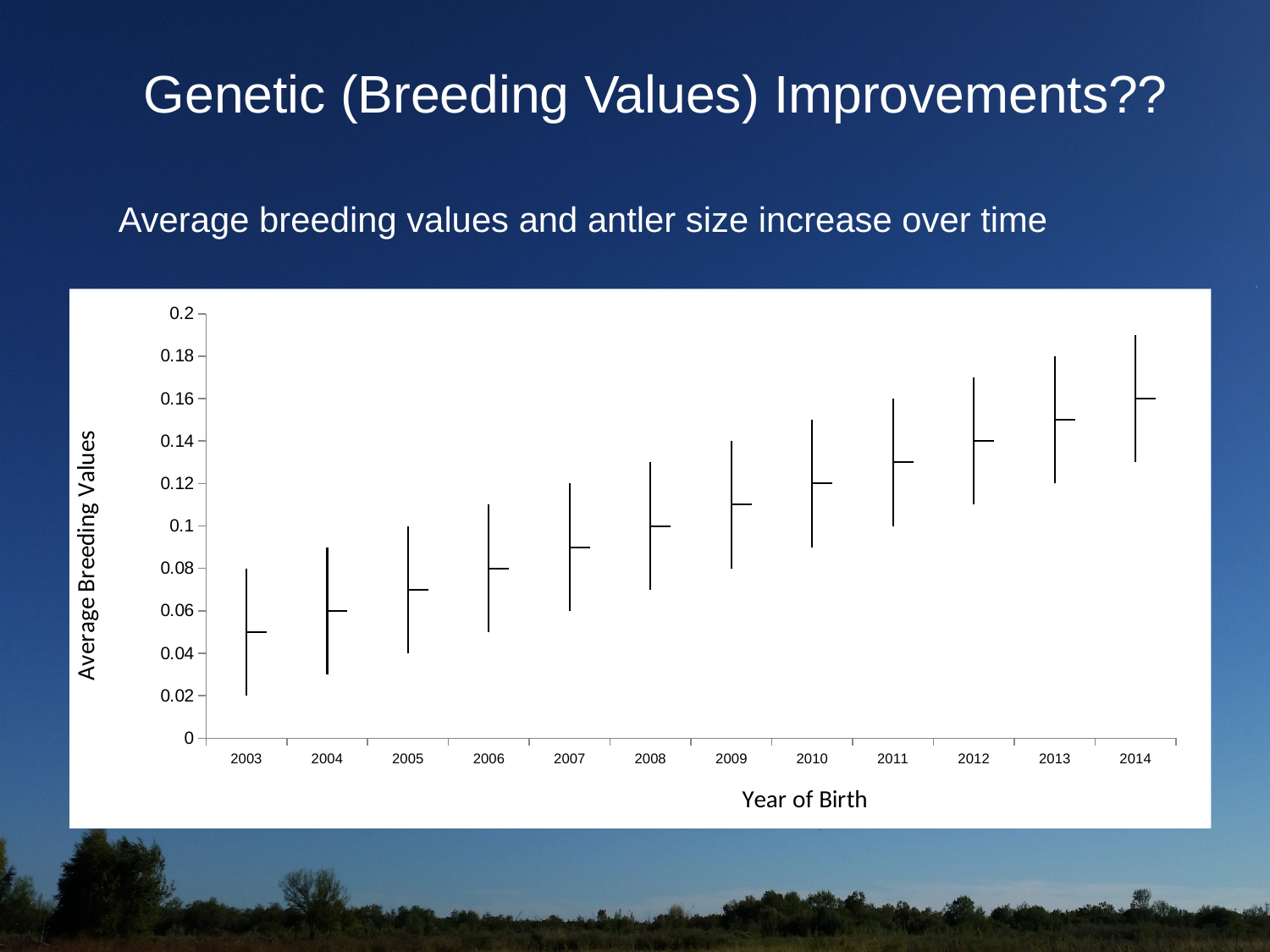
Is the average breeding value for 2013 greater or less than 0.14? greater What is the average breeding value for the 2008 birth year? 0.1 Which year of birth has the highest average breeding value? 2014 What is the average breeding value for the 2014 birth year? 0.16 Do the average breeding values rise or fall from 2003 to 2014? rise What is the average breeding value for the 2010 birth year? 0.12 Which birth year has the larger average breeding value, 2005 or 2011? 2011 What is the label on the y axis of the chart? Average Breeding Values Is the average breeding value for 2003 greater or less than 0.06? less Which year of birth has the lowest average breeding value? 2003 How many years of birth are shown on the x axis of the chart? 12 What is the label on the x axis of the chart? Year of Birth